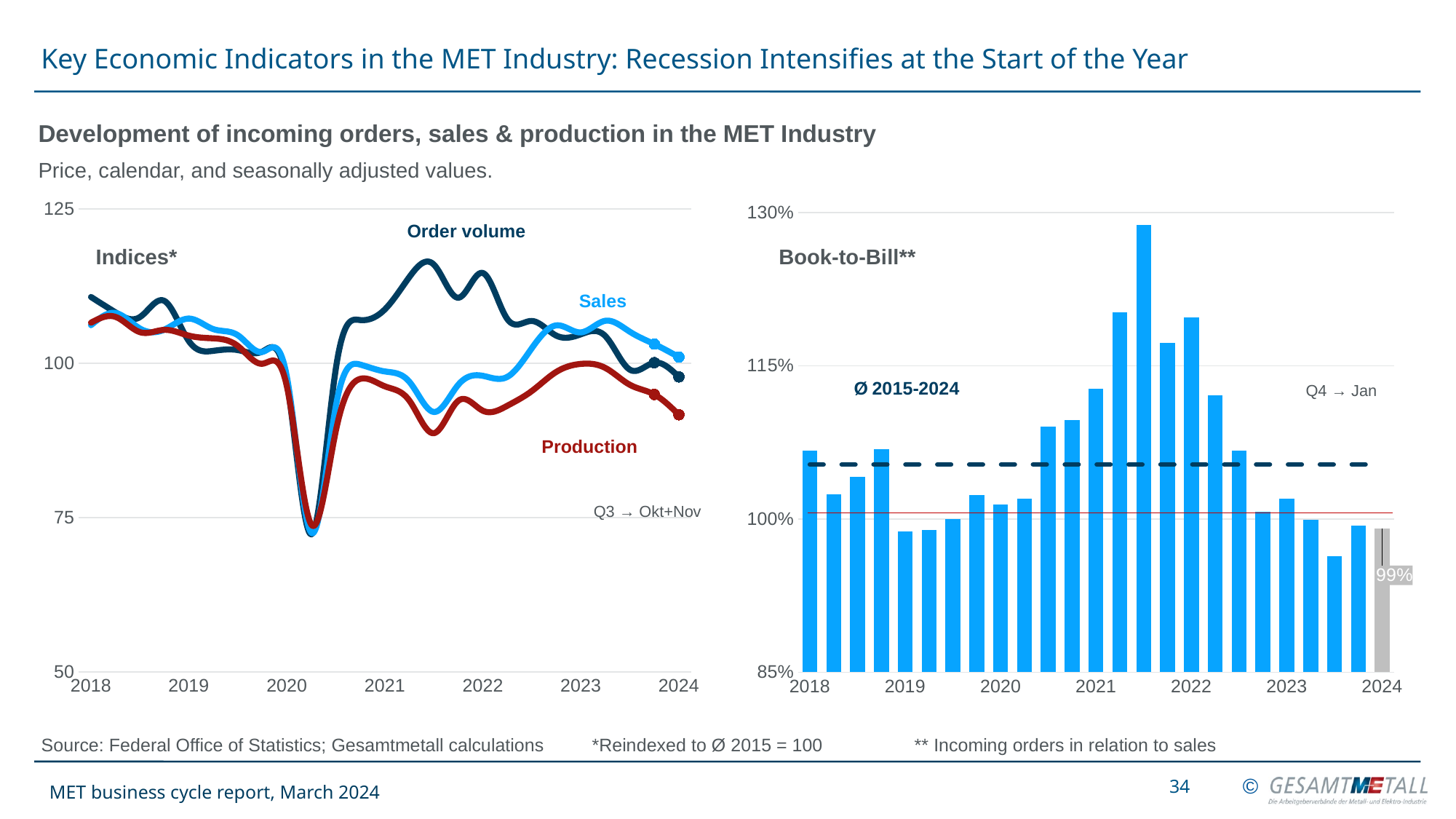
In the Book-to-Bill** chart, is the first bar for 2018 greater or less than 100%? greater What kind of chart is the Indices* chart on the left? line chart In the Book-to-Bill** chart, what does the dashed horizontal line represent? Ø 2015-2024 In the Indices* chart, which series has the lowest value at the end of the plotted period in 2024? Production In the Indices* chart, does the Production line rise or fall from 2023 to 2024? fall In the Indices* chart, is the lowest value of the Sales line in 2020 greater or less than 75? less In the Book-to-Bill** chart, in which year does the highest bar occur? 2021 In the Book-to-Bill** chart, what value is printed on the last (grey) bar for 2024? 99% What kind of chart is the Book-to-Bill** chart on the right? bar chart In the Indices* chart, is the peak of the Order volume line in 2021 greater or less than 100? greater How many series are plotted in the Indices* chart on the left? 3